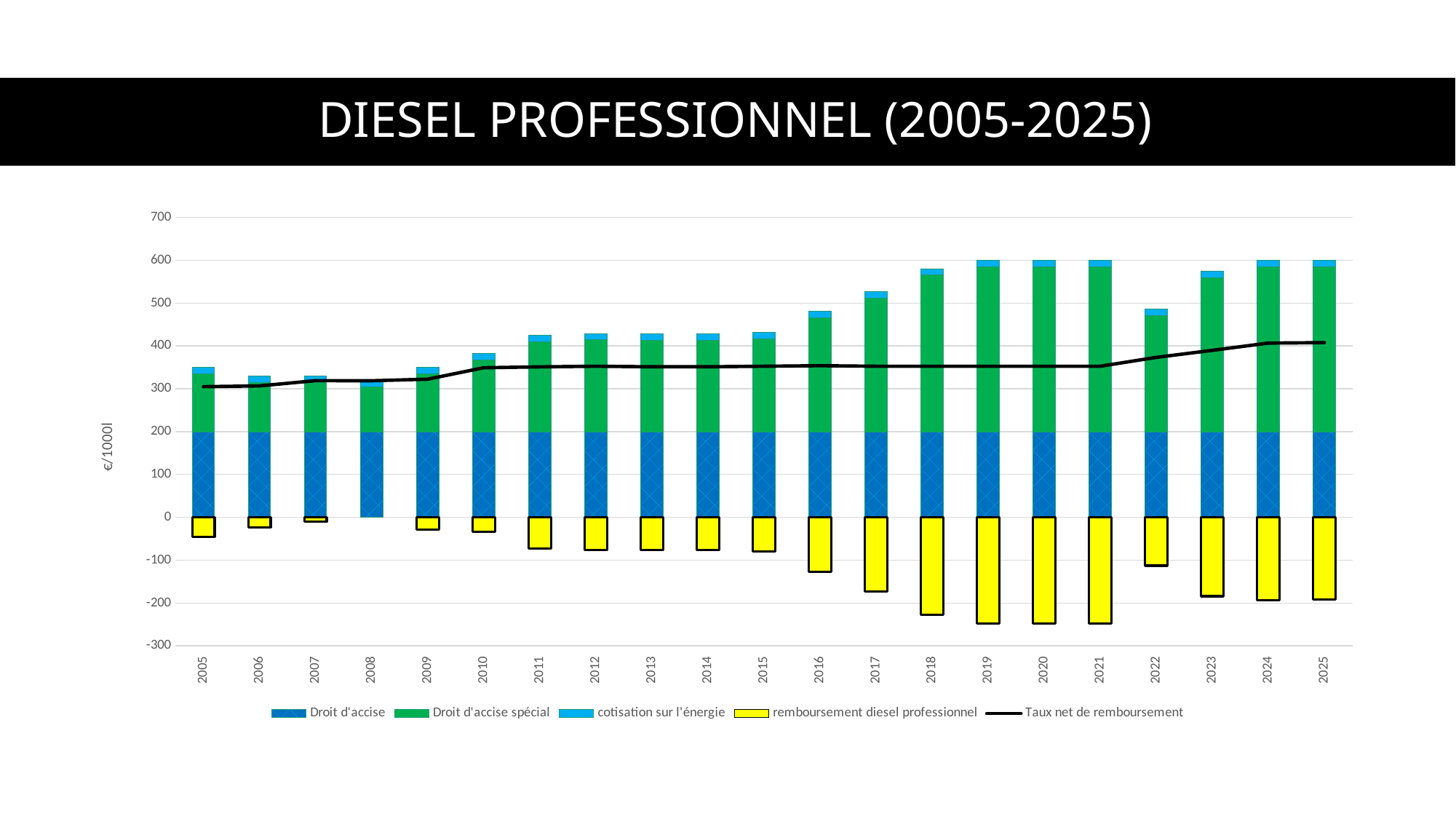
Is the total of the stacked bar for 2005 greater or less than 300? greater How many years are shown on the x axis? 21 Is the remboursement diesel professionnel value for 2019 greater or less than -200? less Is the total of the stacked bar for 2017 greater or less than 500? greater Which year has the larger stacked bar total, 2010 or 2016? 2016 What is the title of the chart? DIESEL PROFESSIONNEL (2005-2025) What kind of chart is shown on the slide? Stacked bar chart with a line What is the label on the vertical axis? €/1000l Does the Taux net de remboursement line generally rise or fall from 2005 to 2025? rise How many series does the legend list? 5